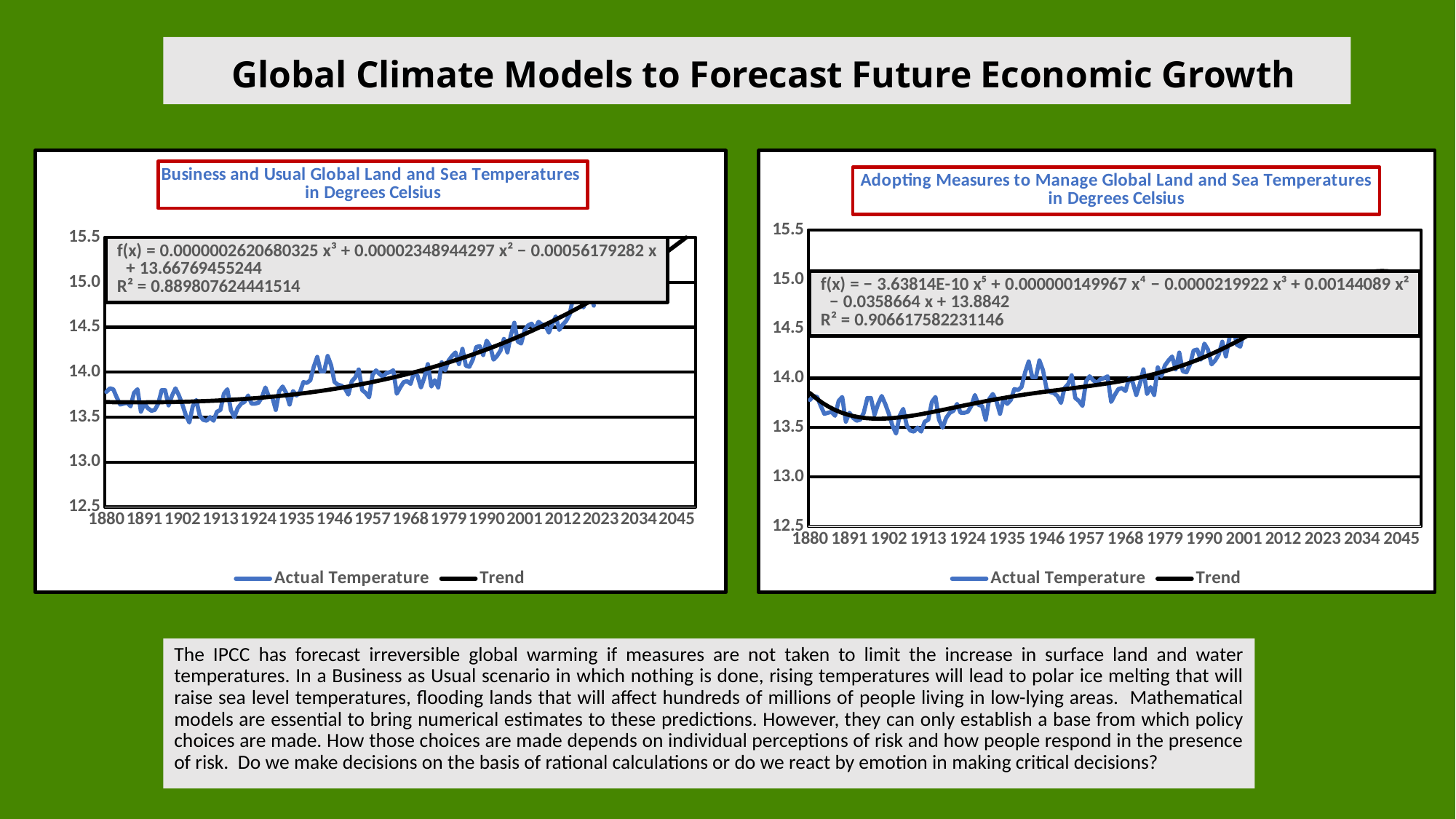
In the 'Adopting Measures to Manage Global Land and Sea Temperatures in Degrees Celsius' chart, is the Trend value at 1902 greater or less than 14.0? less In the 'Business and Usual Global Land and Sea Temperatures in Degrees Celsius' chart, is the Actual Temperature value at 1880 greater or less than 14.0? less What are the two legend entries in the 'Business and Usual Global Land and Sea Temperatures in Degrees Celsius' chart? Actual Temperature and Trend How many series does the legend of the 'Adopting Measures to Manage Global Land and Sea Temperatures in Degrees Celsius' chart list? 2 In the 'Adopting Measures to Manage Global Land and Sea Temperatures in Degrees Celsius' chart, is the Actual Temperature value at 2001 greater or less than 14.0? greater In the 'Adopting Measures to Manage Global Land and Sea Temperatures in Degrees Celsius' chart, which is larger: the Trend value at 1902 or at 2001? 2001 In the 'Business and Usual Global Land and Sea Temperatures in Degrees Celsius' chart, does the Trend line rise or fall overall from 1880 to 2045? rise In the 'Adopting Measures to Manage Global Land and Sea Temperatures in Degrees Celsius' chart, does the Actual Temperature line rise or fall overall from 1880 to 2001? rise What kind of chart is the 'Business and Usual Global Land and Sea Temperatures in Degrees Celsius' chart? line chart What R² value is printed on the 'Business and Usual Global Land and Sea Temperatures in Degrees Celsius' chart? 0.889807624441514